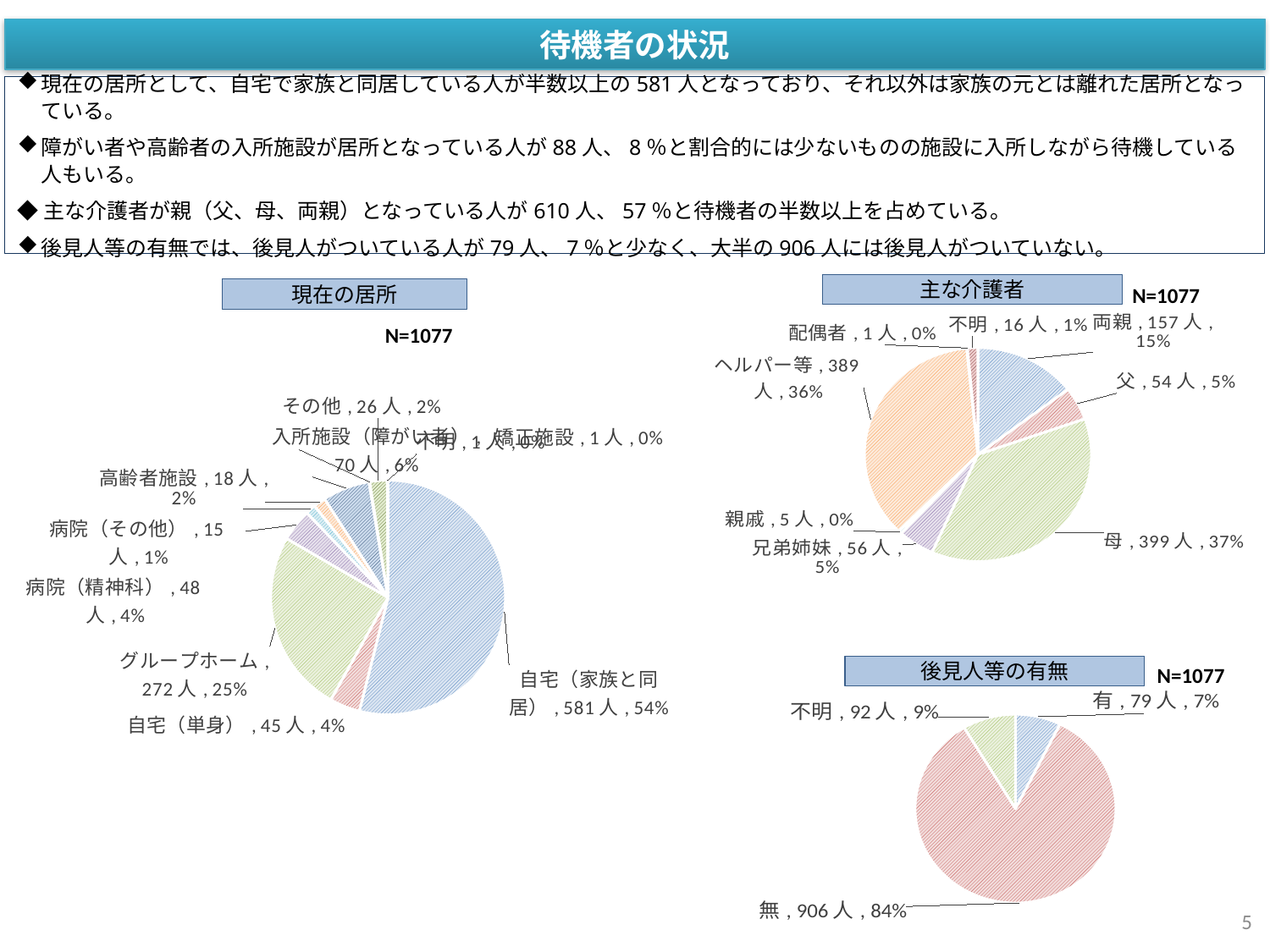
In the 現在の居所 chart, how many people are in the グループホーム category? 272 人 How many categories does the 主な介護者 pie chart have? 8 In the 主な介護者 chart, which has more people, 母 or ヘルパー等? 母 In the 後見人等の有無 chart, what share of the pie does 無 represent? 84% In the 後見人等の有無 chart, what is the difference in people between 無 and 有? 827 人 In the 現在の居所 chart, what share of the pie does 自宅（家族と同居） represent? 54% In the 主な介護者 chart, how many people are in the 母 category? 399 人 In the 現在の居所 chart, which category has the largest slice? 自宅（家族と同居） In the 主な介護者 chart, which category has the smallest number of people? 配偶者 What kind of chart is the 現在の居所 chart? pie chart In the 現在の居所 chart, what is the difference in people between 自宅（家族と同居） and グループホーム? 309 人 How many categories does the 後見人等の有無 pie chart have? 3